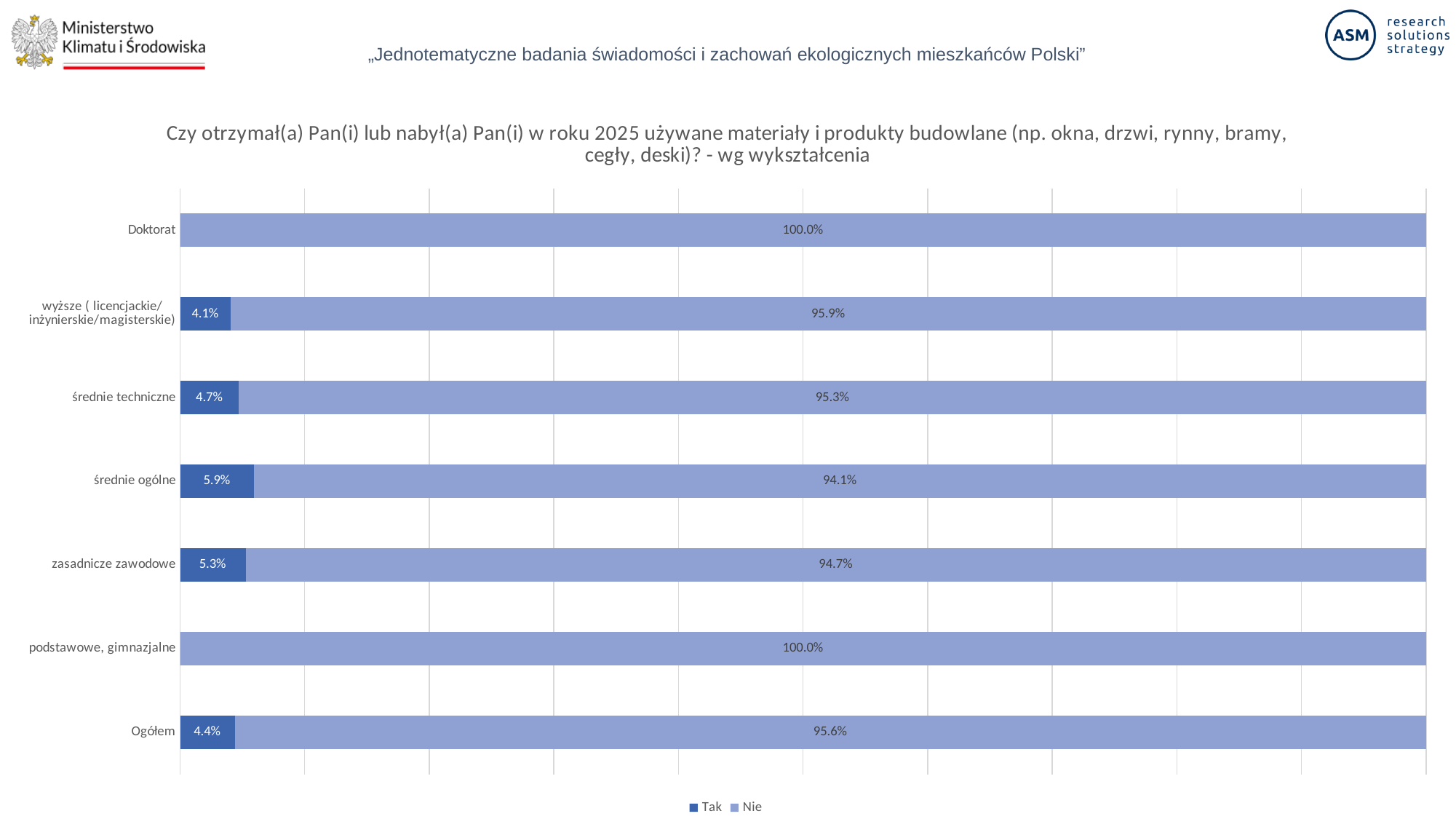
How many series does the legend list? 2 What kind of chart is shown on the slide? Stacked bar chart What is the "Nie" value for wyższe (licencjackie/inżynierskie/magisterskie)? 95.9% What is the "Tak" value for średnie ogólne? 5.9% Among the categories with a printed "Tak" value, which has the lowest "Tak" value? wyższe (licencjackie/inżynierskie/magisterskie) What is the "Nie" value for Doktorat? 100.0% What is the "Tak" value for Ogółem? 4.4% What is the total of the stacked bar for Ogółem? 100.0% How many education categories are shown on the chart? 7 What is the difference in percentage points between the "Tak" values for średnie ogólne and zasadnicze zawodowe? 0.6 Which education category has the highest "Tak" value? średnie ogólne Which has a larger "Nie" value: średnie techniczne or średnie ogólne? średnie techniczne